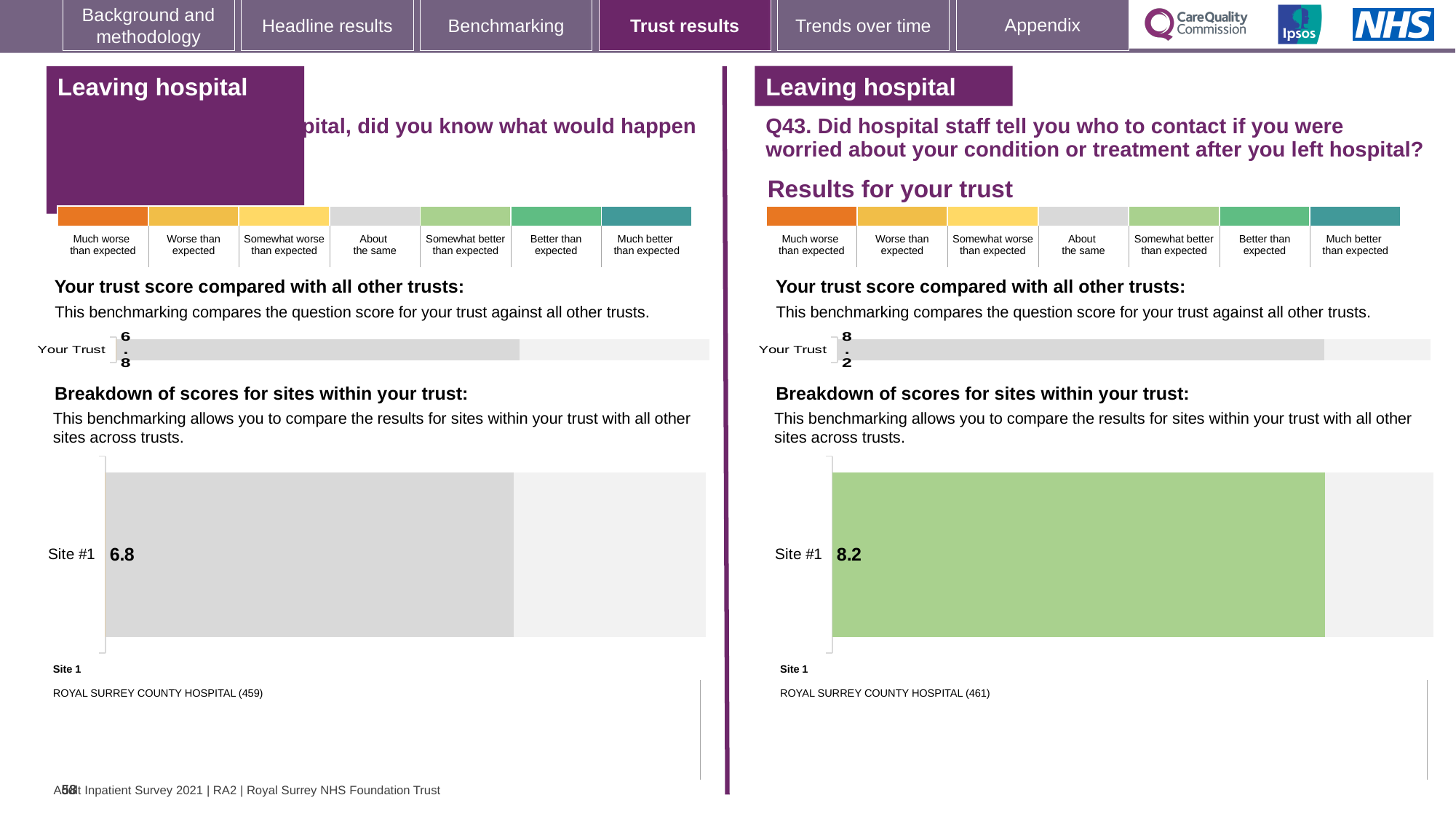
On the right half of the slide (Q43), what score is shown for Site #1 in the 'Breakdown of scores for sites within your trust' chart? 8.2 On the left half of the slide, what score is shown for Site #1 in the 'Breakdown of scores for sites within your trust' chart? 6.8 Which site name is listed as Site 1 below the breakdown chart on the right half of the slide (Q43)? ROYAL SURREY COUNTY HOSPITAL (461) What colour is the Site #1 bar in the 'Breakdown of scores for sites within your trust' chart on the left half of the slide? Grey What is the difference between the Site #1 score in the right-hand (Q43) breakdown chart and the Site #1 score in the left-hand breakdown chart? 1.4 On the right half of the slide (Q43), what is the score shown for Your Trust in the 'Your trust score compared with all other trusts' chart? 8.2 What colour is the Site #1 bar in the 'Breakdown of scores for sites within your trust' chart on the right half of the slide (Q43)? Green On the left half of the slide, what is the score shown for Your Trust in the 'Your trust score compared with all other trusts' chart? 6.8 How many sites are plotted in the 'Breakdown of scores for sites within your trust' chart on the left half of the slide? 1 How many sites are plotted in the 'Breakdown of scores for sites within your trust' chart on the right half of the slide (Q43)? 1 What type of chart is used for the 'Breakdown of scores for sites within your trust' on the right half of the slide (Q43)? Bar chart Which is larger: the Site #1 score in the left-hand breakdown chart or the Site #1 score in the right-hand (Q43) breakdown chart? The right-hand (Q43) chart